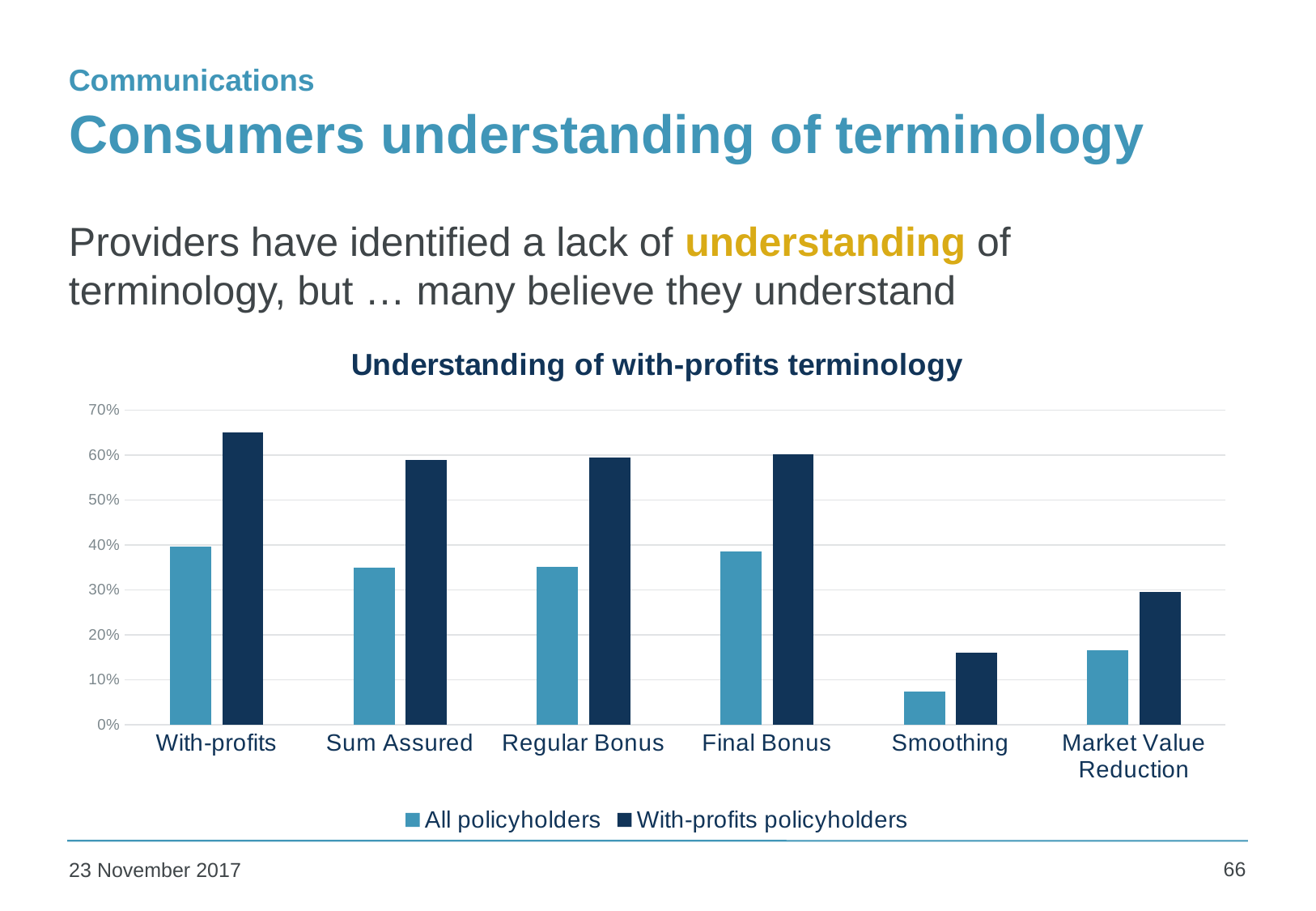
Is the value for With-profits policyholders in the Sum Assured category greater or less than 50%? greater Is the value for With-profits policyholders in the With-profits category greater or less than 60%? greater What kind of chart is shown on the slide? bar chart What is the title of the chart? Understanding of with-profits terminology In the Final Bonus category, which series has the larger value: All policyholders or With-profits policyholders? With-profits policyholders For All policyholders, which is larger: Smoothing or Market Value Reduction? Market Value Reduction Which category has the lowest value for All policyholders? Smoothing How many terminology categories are shown on the x axis? 6 Which category has the lowest value for With-profits policyholders? Smoothing Which category has the highest value for With-profits policyholders? With-profits How many series does the legend list? 2 Is the value for All policyholders in the Smoothing category greater or less than 10%? less